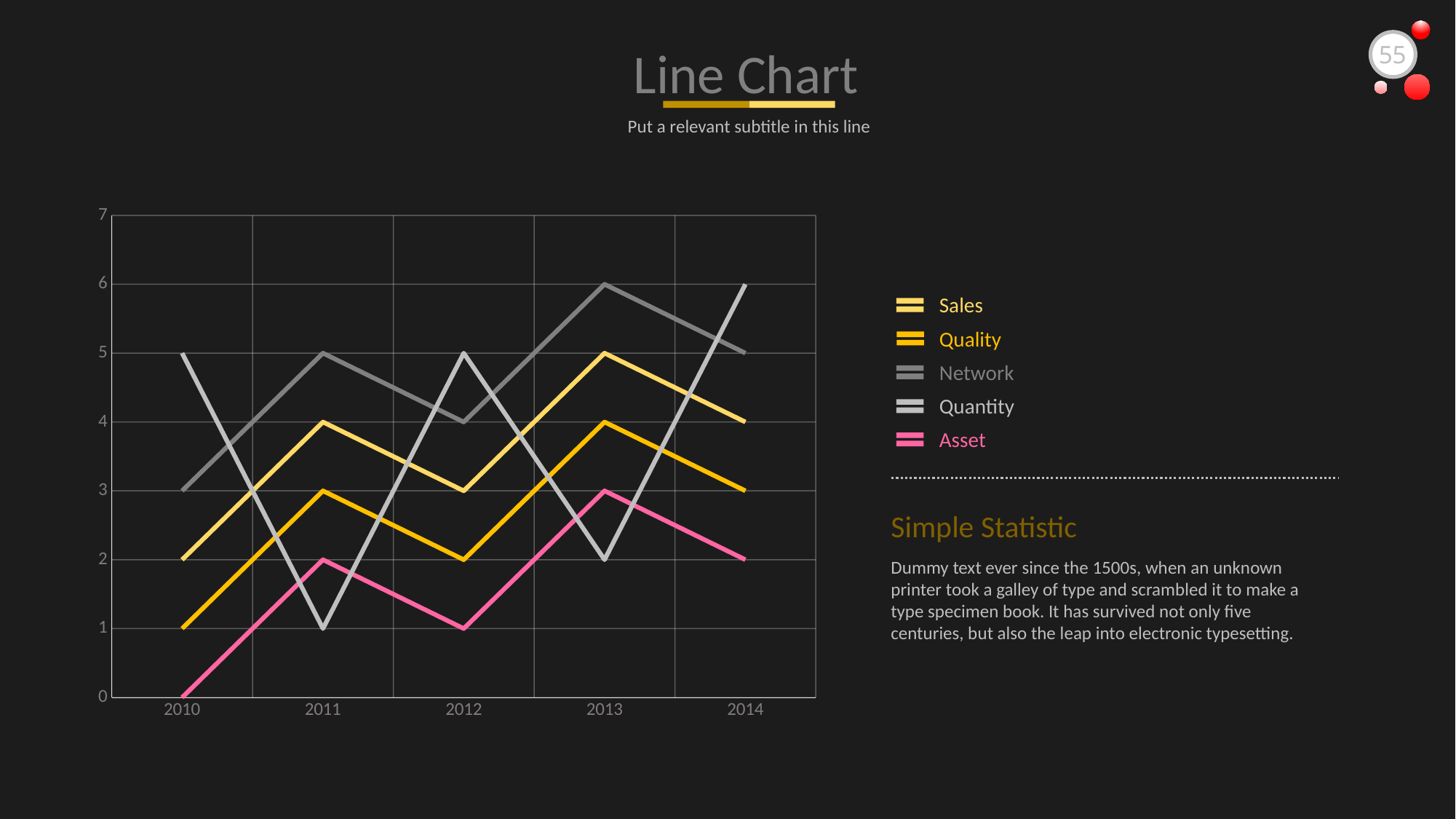
How many series does the legend list? 5 What is the value for Asset in 2013? 3 In which year is the Asset series lowest? 2010 What is the value for Quantity in 2011? 1 What is the value for Sales in 2013? 5 How many years are shown on the x axis? 5 Which is larger in 2011, Network or Quantity? Network Which series is drawn in pink? Asset What kind of chart is shown on the slide? line chart What is the value for Network in 2013? 6 In which year is the Quantity series highest? 2014 What is the difference between Network and Asset in 2013? 3